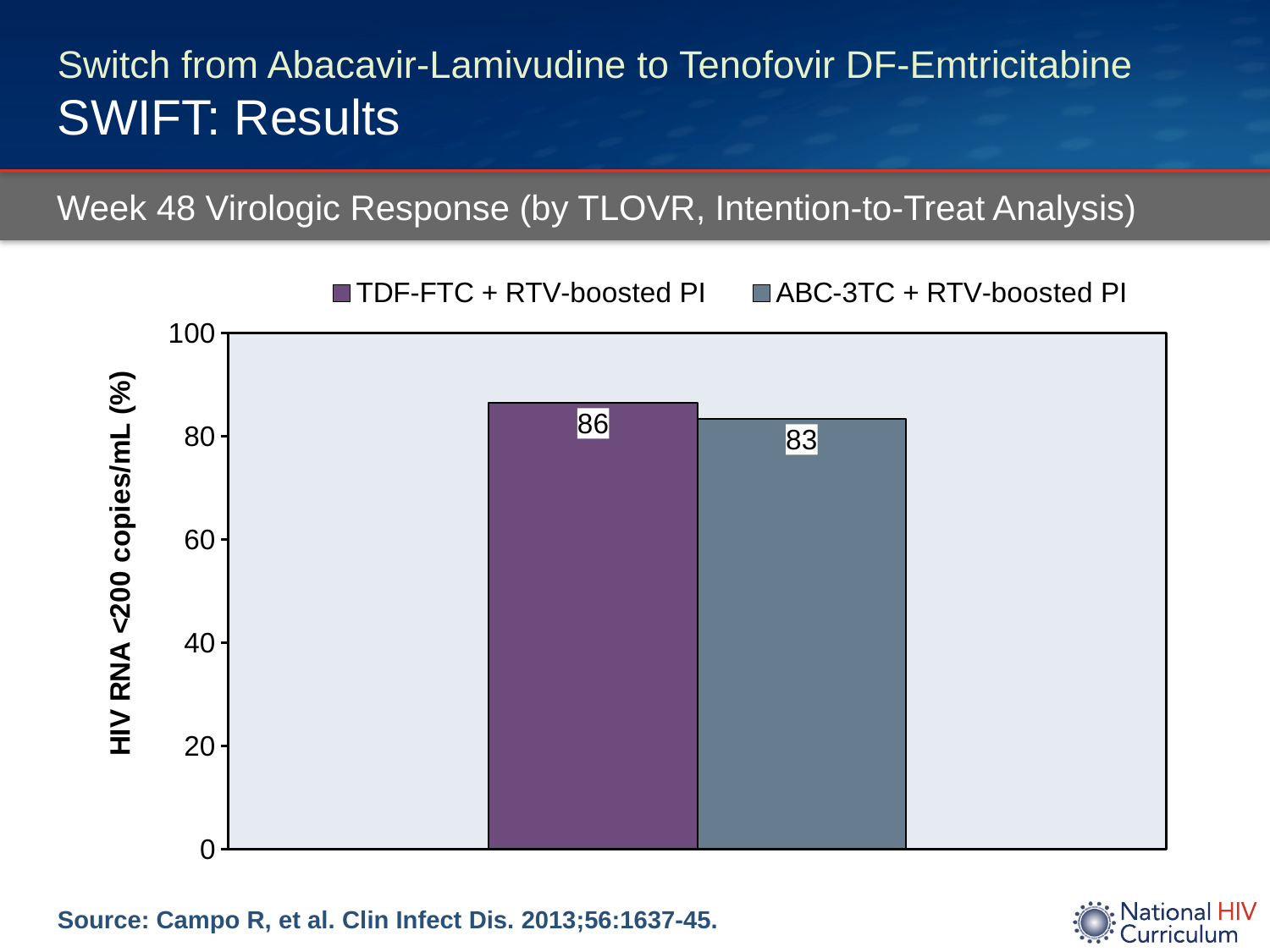
What kind of chart is shown on the slide? bar chart What is the difference between the TDF-FTC + RTV-boosted PI value and the ABC-3TC + RTV-boosted PI value? 3 Is the value for ABC-3TC + RTV-boosted PI greater or less than 80? greater Is the value for TDF-FTC + RTV-boosted PI larger or smaller than the value for ABC-3TC + RTV-boosted PI? larger How many series does the legend list? 2 How many bars are plotted on the chart? 2 What is the value for ABC-3TC + RTV-boosted PI? 83 What is the label of the y axis? HIV RNA <200 copies/mL (%) Is the value for TDF-FTC + RTV-boosted PI greater or less than 100? less What is the value for TDF-FTC + RTV-boosted PI? 86 Which series has the higher value? TDF-FTC + RTV-boosted PI Which series has the lower value? ABC-3TC + RTV-boosted PI